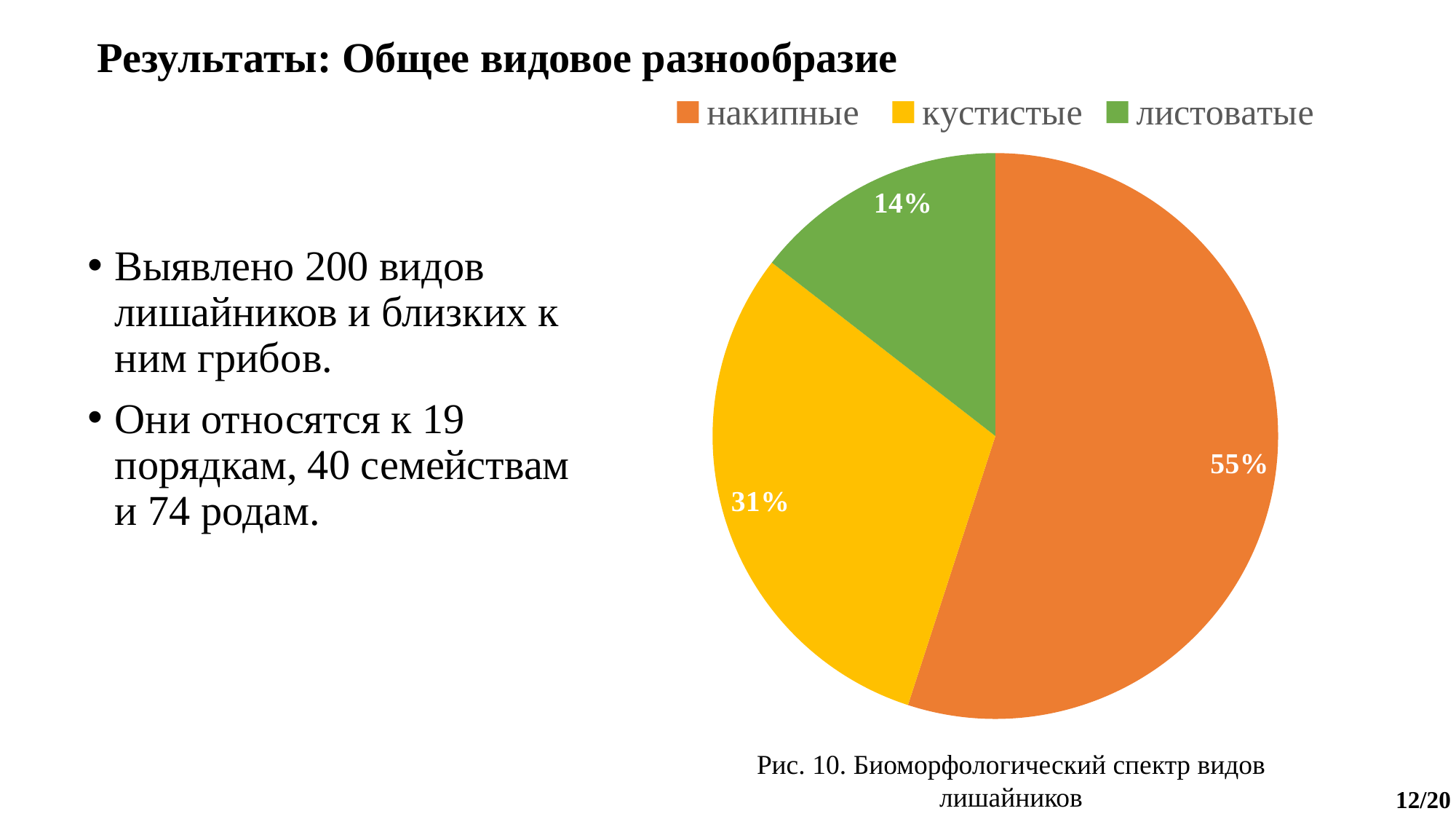
What share of the pie does кустистые have? 31% What kind of chart is shown on the slide? pie chart What is the difference in percentage points between накипные and кустистые? 24 Which is larger, the share for кустистые or the share for листоватые? кустистые What share of the pie does накипные have? 55% How many entries does the legend list? 3 What colour is the slice for листоватые? green Which category has the largest slice of the pie? накипные How many slices does the pie chart have? 3 Which category has the smallest slice of the pie? листоватые What share of the pie does листоватые have? 14% What is the difference in percentage points between кустистые and листоватые? 17